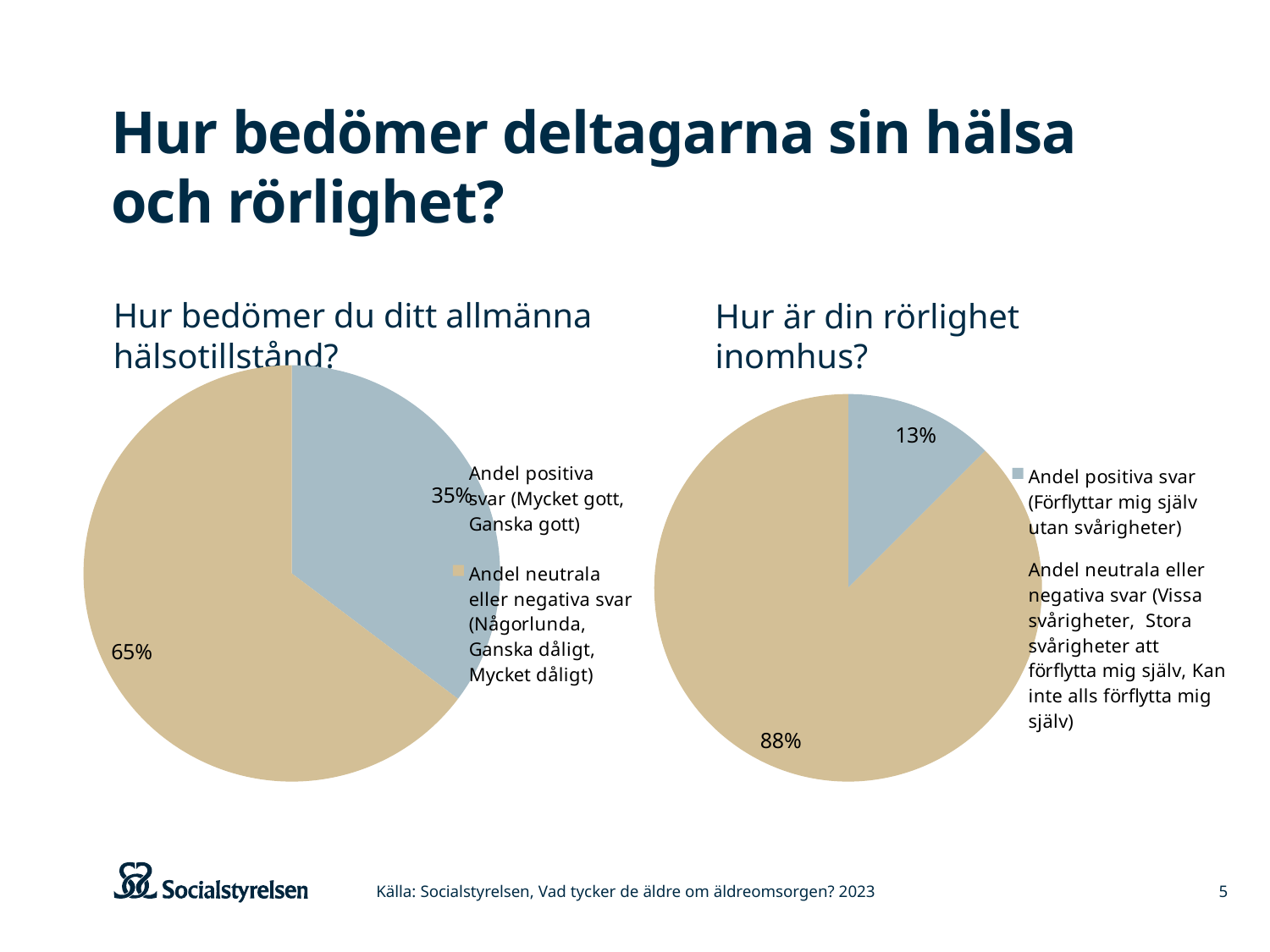
In the chart "Hur är din rörlighet inomhus?", what colour is the slice for Andel positiva svar? Blue-grey In the chart "Hur bedömer du ditt allmänna hälsotillstånd?", what share is labelled for Andel neutrala eller negativa svar? 65% How many slices does the chart "Hur är din rörlighet inomhus?" have? 2 What kind of chart is used for "Hur bedömer du ditt allmänna hälsotillstånd?"? Pie chart Which chart has the larger share of Andel positiva svar: "Hur bedömer du ditt allmänna hälsotillstånd?" or "Hur är din rörlighet inomhus?"? Hur bedömer du ditt allmänna hälsotillstånd? In the chart "Hur bedömer du ditt allmänna hälsotillstånd?", what share is labelled for Andel positiva svar? 35% In the chart "Hur bedömer du ditt allmänna hälsotillstånd?", what is the difference in percentage points between the neutral/negative slice and the positive slice? 30 percentage points How many entries does the legend of the chart "Hur bedömer du ditt allmänna hälsotillstånd?" list? 2 In the chart "Hur är din rörlighet inomhus?", what share is labelled for Andel neutrala eller negativa svar? 88% In the chart "Hur är din rörlighet inomhus?", what share is labelled for Andel positiva svar? 13% In the chart "Hur är din rörlighet inomhus?", which slice is the smallest? Andel positiva svar In the chart "Hur bedömer du ditt allmänna hälsotillstånd?", which slice is the largest? Andel neutrala eller negativa svar